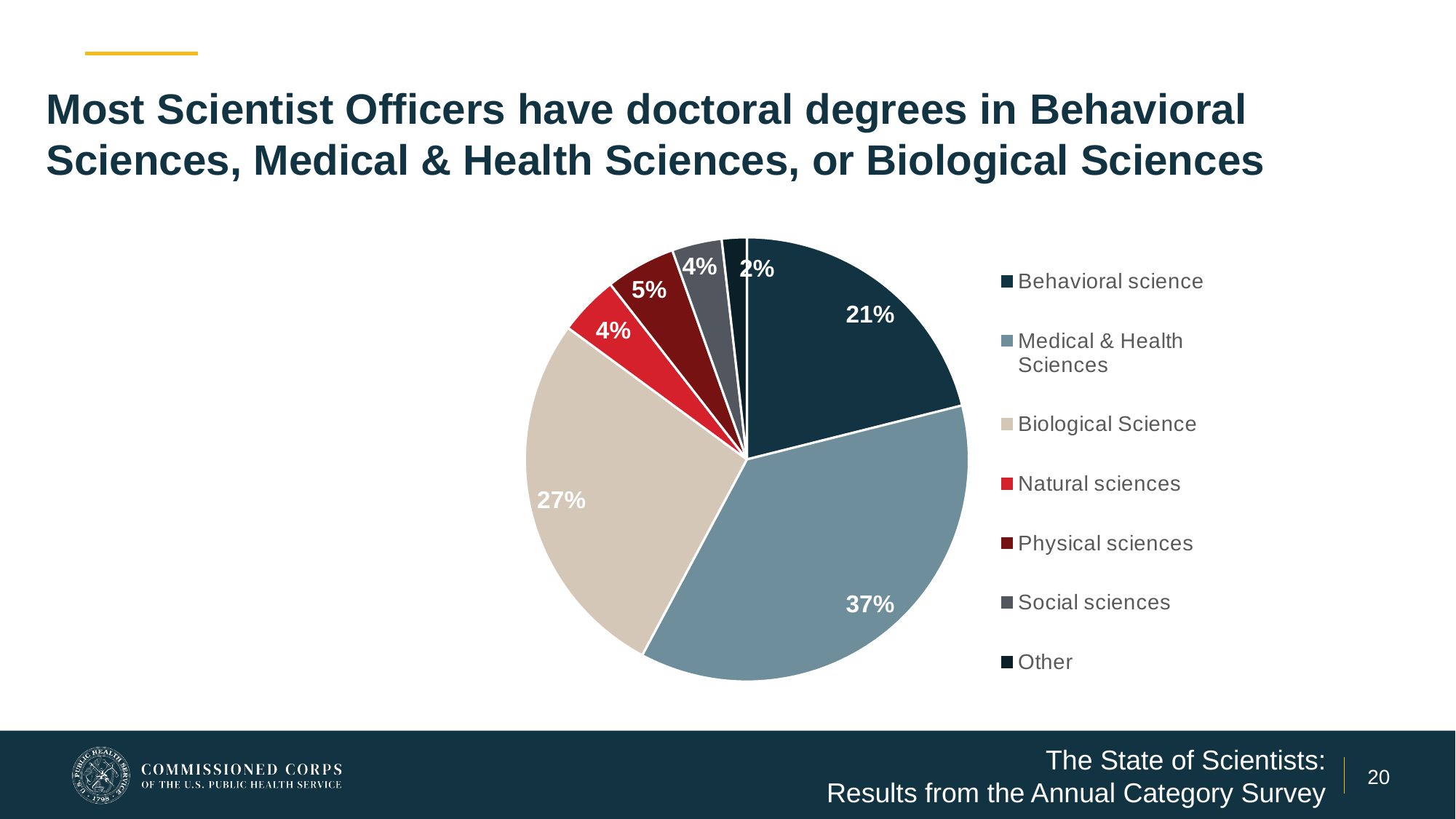
Which is larger, the share for Behavioral science or the share for Biological Science? Biological Science How many categories does the legend list? 7 What share of the pie is Medical & Health Sciences? 37% Which category is shown in red in the pie chart? Natural sciences What share of the pie is Physical sciences? 5% Which category has the smallest slice of the pie? Other What share of the pie is Biological Science? 27% Which category has the largest slice of the pie? Medical & Health Sciences What kind of chart is shown on the slide? pie chart What share of the pie is Other? 2% What share of the pie is Behavioral science? 21% What is the difference in percentage points between Medical & Health Sciences and Biological Science? 10